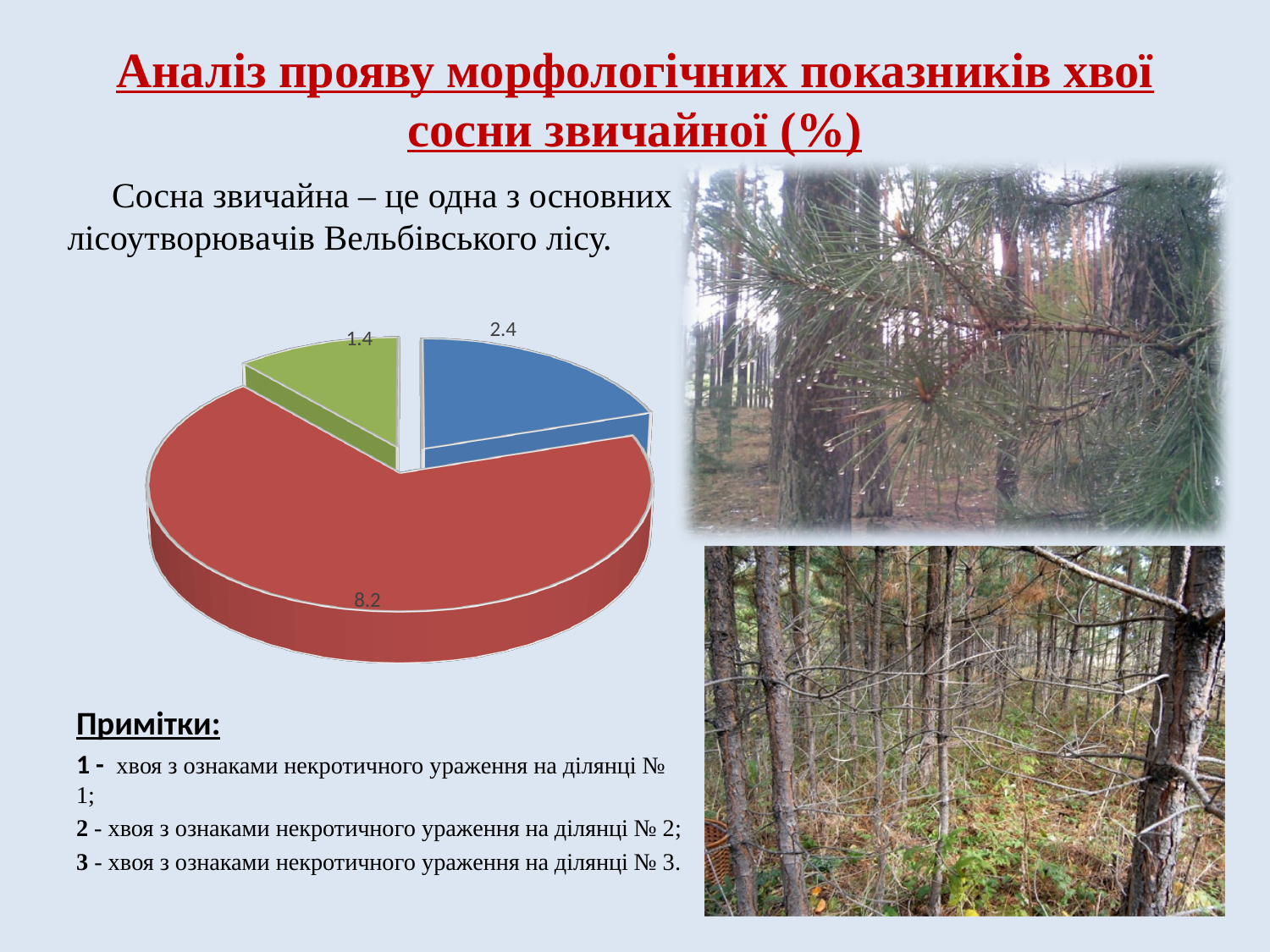
Which slice of the pie chart has the smallest value? the green slice (1.4) What value is labelled on the green slice of the pie chart? 1.4 What is the title of the slide containing the pie chart? Аналіз прояву морфологічних показників хвої сосни звичайної (%) What kind of chart is shown on the slide? pie chart Which slice of the pie chart has the largest value? the red slice (8.2) What is the difference between the blue slice value and the green slice value in the pie chart? 1 What is the difference between the red slice value and the blue slice value in the pie chart? 5.8 How many slices does the pie chart have? 3 What value is labelled on the blue slice of the pie chart? 2.4 Which is larger in the pie chart, the blue slice or the green slice? the blue slice What value is labelled on the red slice of the pie chart? 8.2 What is the sum of all three slice values shown in the pie chart? 12